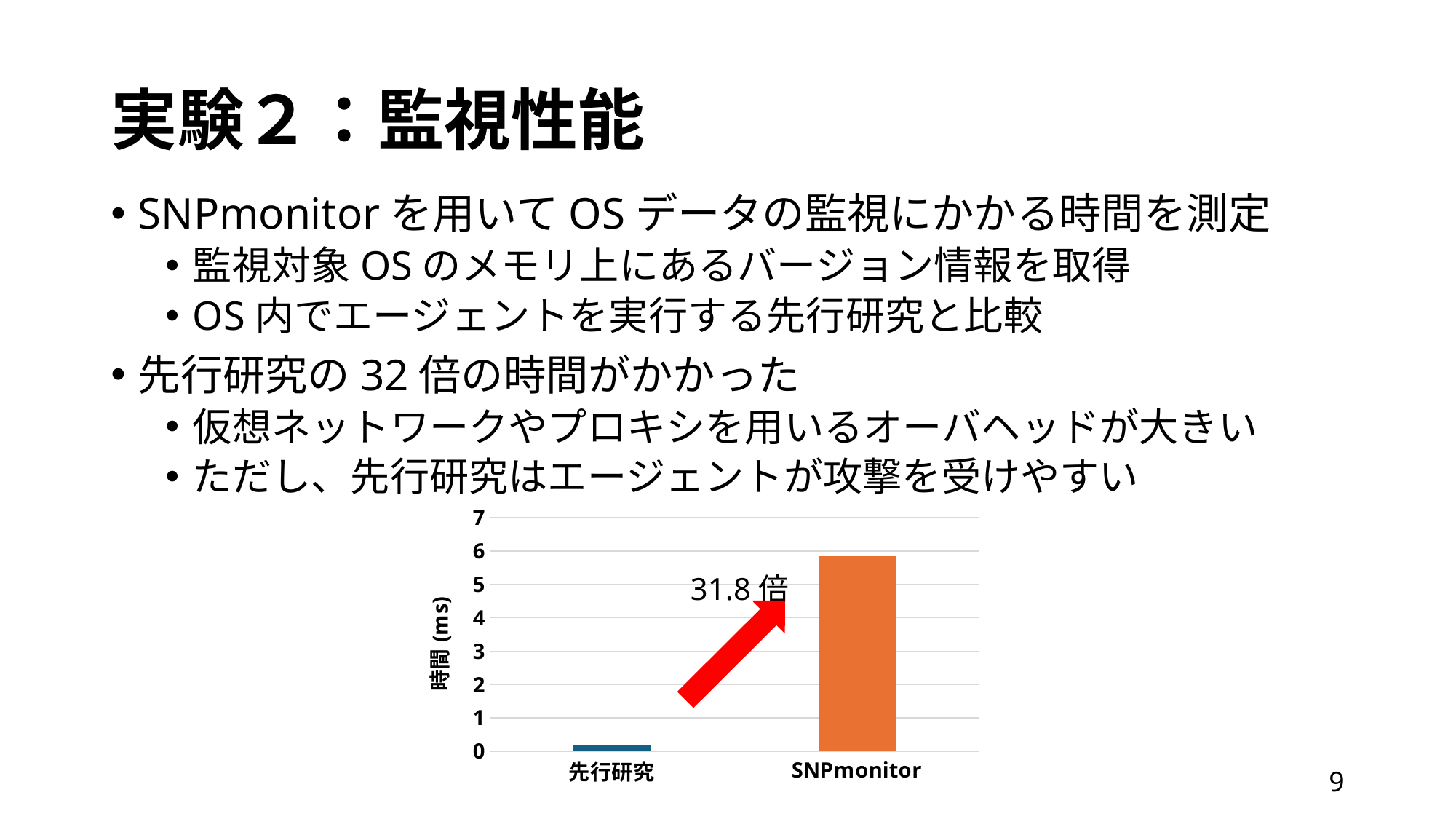
What is the label of the y axis of the chart? 時間 (ms) Which is larger, the value for 先行研究 or the value for SNPmonitor? SNPmonitor Is the value for SNPmonitor greater or less than 3? greater What ratio is written in the annotation next to the red arrow on the chart? 31.8 倍 Which category has the lowest value in the chart? 先行研究 Which category has the highest value in the chart? SNPmonitor What kind of chart is shown on the slide? bar chart Is the value for SNPmonitor greater or less than 5? greater How many categories are plotted on the x axis of the chart? 2 Is the value for 先行研究 greater or less than 1? less